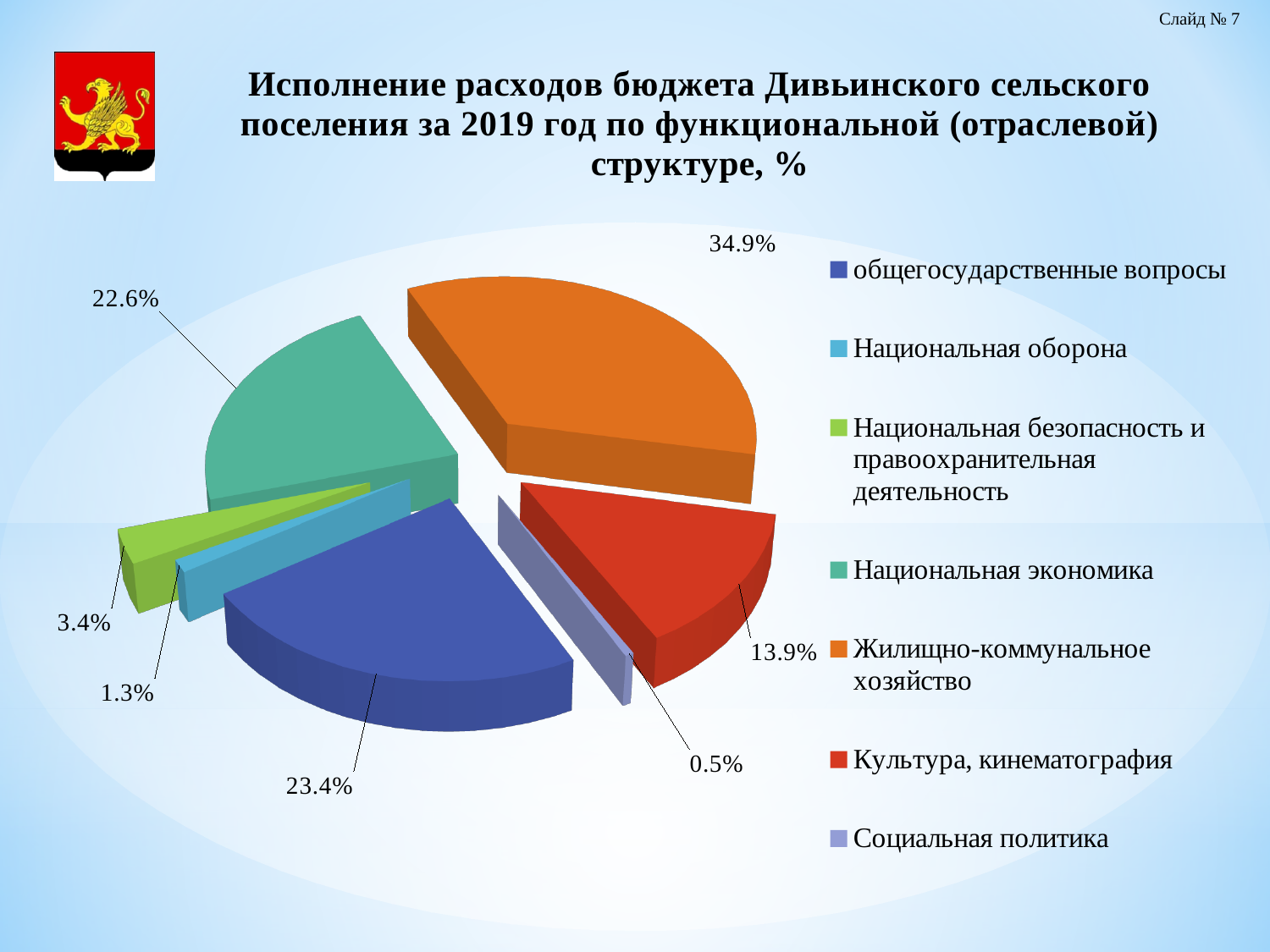
What is the difference between the shares of Жилищно-коммунальное хозяйство and Культура, кинематография? 21.0% What is the value for Культура, кинематография? 13.9% What is the value for Национальная оборона? 1.3% How many categories does the legend list? 7 What is the value for Социальная политика? 0.5% What is the value for Национальная экономика? 22.6% Which category has the largest share of the pie? Жилищно-коммунальное хозяйство Which category has the smallest share of the pie? Социальная политика What is the value for общегосударственные вопросы? 23.4% What share of budget expenditure goes to Жилищно-коммунальное хозяйство? 34.9% Which is larger: the share of общегосударственные вопросы or Национальная экономика? общегосударственные вопросы What type of chart is shown on the slide? pie chart